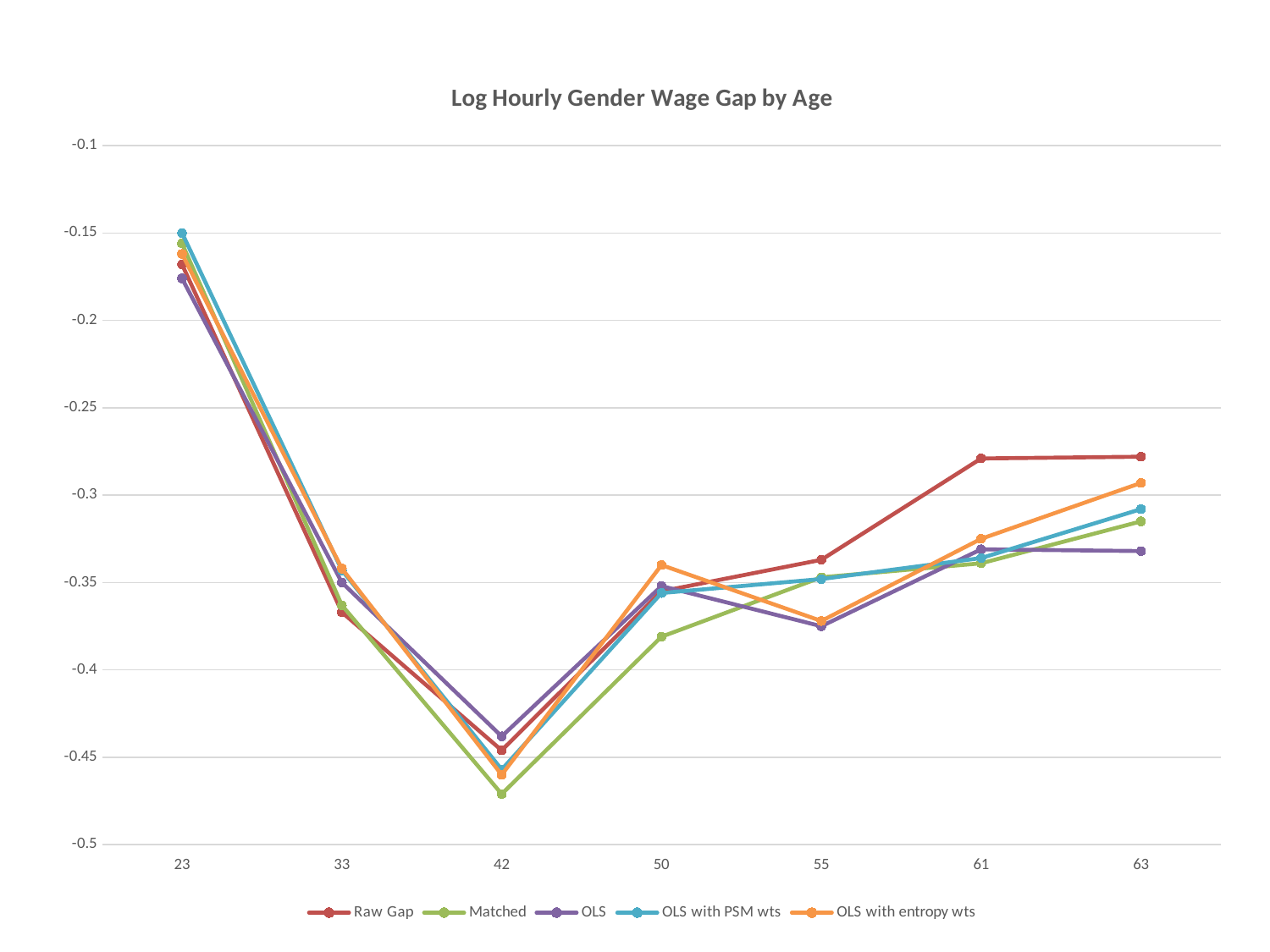
How many age categories are shown on the x axis? 7 Is the value for Matched at age 42 greater or less than -0.45? less At which age does the Matched series reach its lowest value? 42 Is the value for Raw Gap at age 61 greater or less than -0.3? greater What kind of chart is shown on the slide? line chart Do the values for the Raw Gap series rise or fall from age 23 to age 42? fall What is the title of the chart? Log Hourly Gender Wage Gap by Age Which series has the lowest value at age 42? Matched How many series does the legend list? 5 At which age does the Raw Gap series reach its highest value? 23 At age 55, which is larger: the Raw Gap value or the OLS value? Raw Gap Which series has the highest value at age 63? Raw Gap